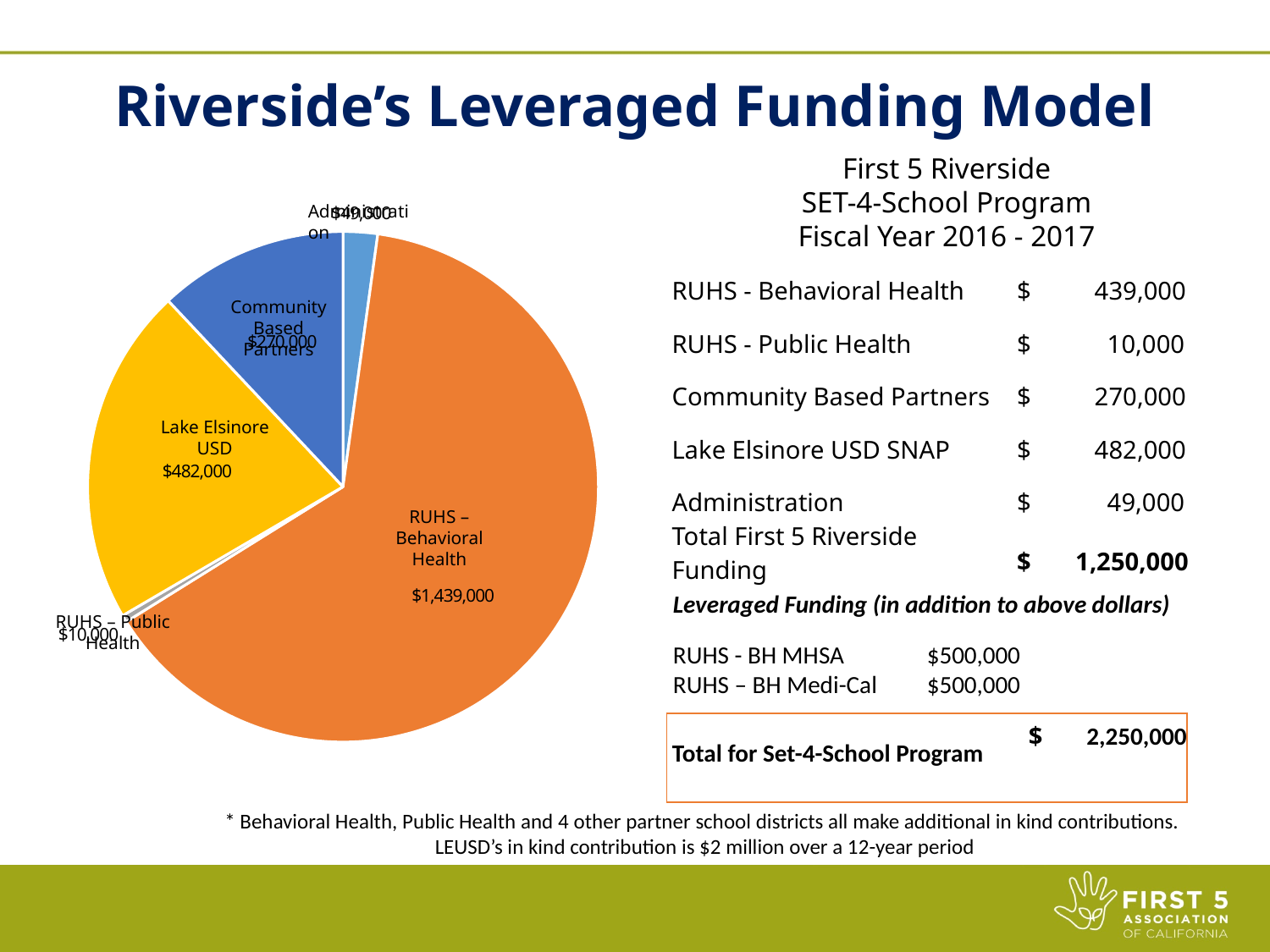
What is the difference between the RUHS – Behavioral Health value and the Lake Elsinore USD value in the pie chart? $957,000 What colour is the RUHS – Behavioral Health slice in the pie chart? orange What value is shown for the RUHS – Behavioral Health slice of the pie chart? $1,439,000 In the pie chart, which is larger: Lake Elsinore USD or Community Based Partners? Lake Elsinore USD What value is shown for the RUHS – Public Health slice of the pie chart? $10,000 How many slices does the pie chart have? 5 Which category has the smallest slice in the pie chart? RUHS – Public Health Which category has the largest slice in the pie chart? RUHS – Behavioral Health What value is shown for the Community Based Partners slice of the pie chart? $270,000 What is the difference between the Lake Elsinore USD value and the Community Based Partners value in the pie chart? $212,000 What value is shown for the Lake Elsinore USD slice of the pie chart? $482,000 What kind of chart is shown on the slide? pie chart